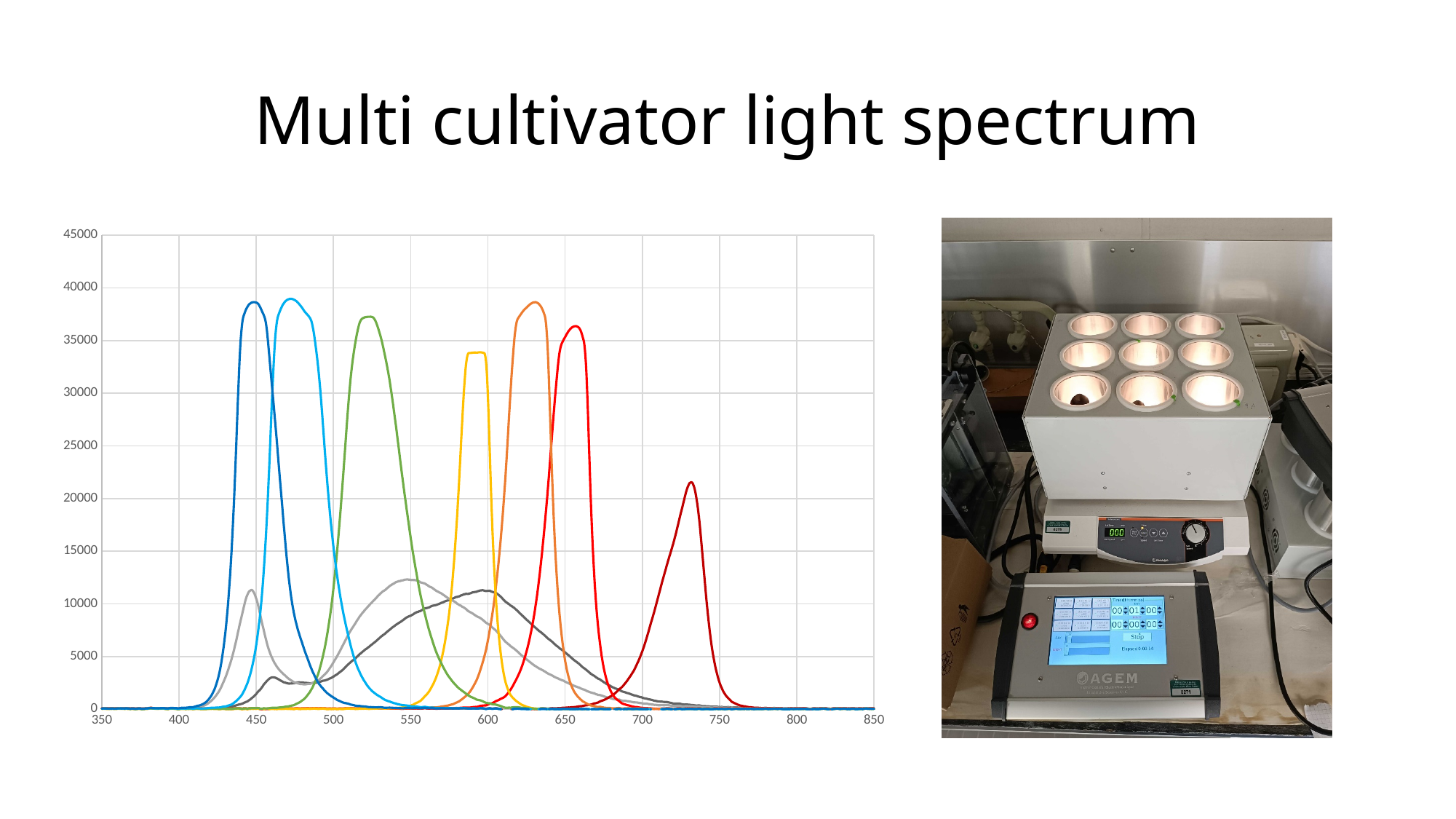
Is the peak of the dark red line greater or less than 15000? greater Among the red, orange and dark red lines, which has the lowest peak? the dark red line What is the title of the slide containing the chart? Multi cultivator light spectrum Is the peak of the dark red line (around 730 on the x axis) greater or less than 25000? less Which line has the higher peak, the yellow line or the dark red line? the yellow line Is the peak of the orange line greater or less than 40000? less What is the highest value shown on the chart's vertical axis? 45000 Which line has the higher peak, the green line or the dark red line? the green line What kind of chart is shown on the slide? line chart